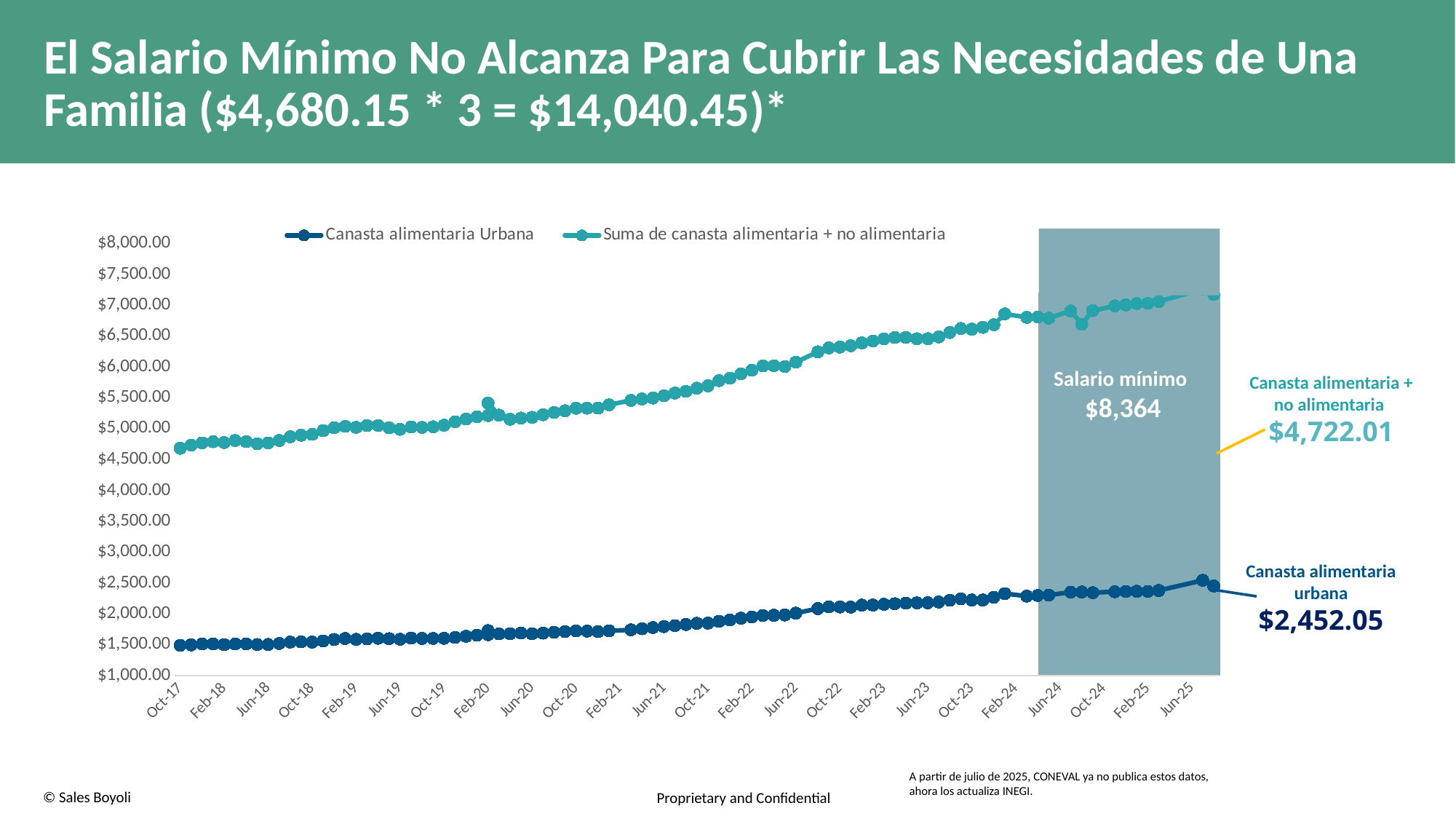
What value is printed for 'Salario mínimo' in the shaded region of the chart? $8,364 Is the value of Canasta alimentaria Urbana at Oct-17 greater or less than $2,000.00? less What value is printed in the annotation labelled 'Canasta alimentaria urbana' at the right of the chart? $2,452.05 What value is printed in the annotation labelled 'Canasta alimentaria + no alimentaria' at the right of the chart? $4,722.01 Is the value of Suma de canasta alimentaria + no alimentaria at Oct-17 greater or less than $5,000.00? less What are the two series named in the chart legend? Canasta alimentaria Urbana; Suma de canasta alimentaria + no alimentaria Is the value of Suma de canasta alimentaria + no alimentaria at Jun-25 greater or less than $7,000.00? greater Which series has higher values throughout the chart, Canasta alimentaria Urbana or Suma de canasta alimentaria + no alimentaria? Suma de canasta alimentaria + no alimentaria What kind of chart is shown on the slide? line chart How many series does the chart legend list? 2 Do the values of the Suma de canasta alimentaria + no alimentaria series generally rise or fall from Oct-17 to Jun-25? rise What is the highest value shown on the chart's vertical axis? $8,000.00